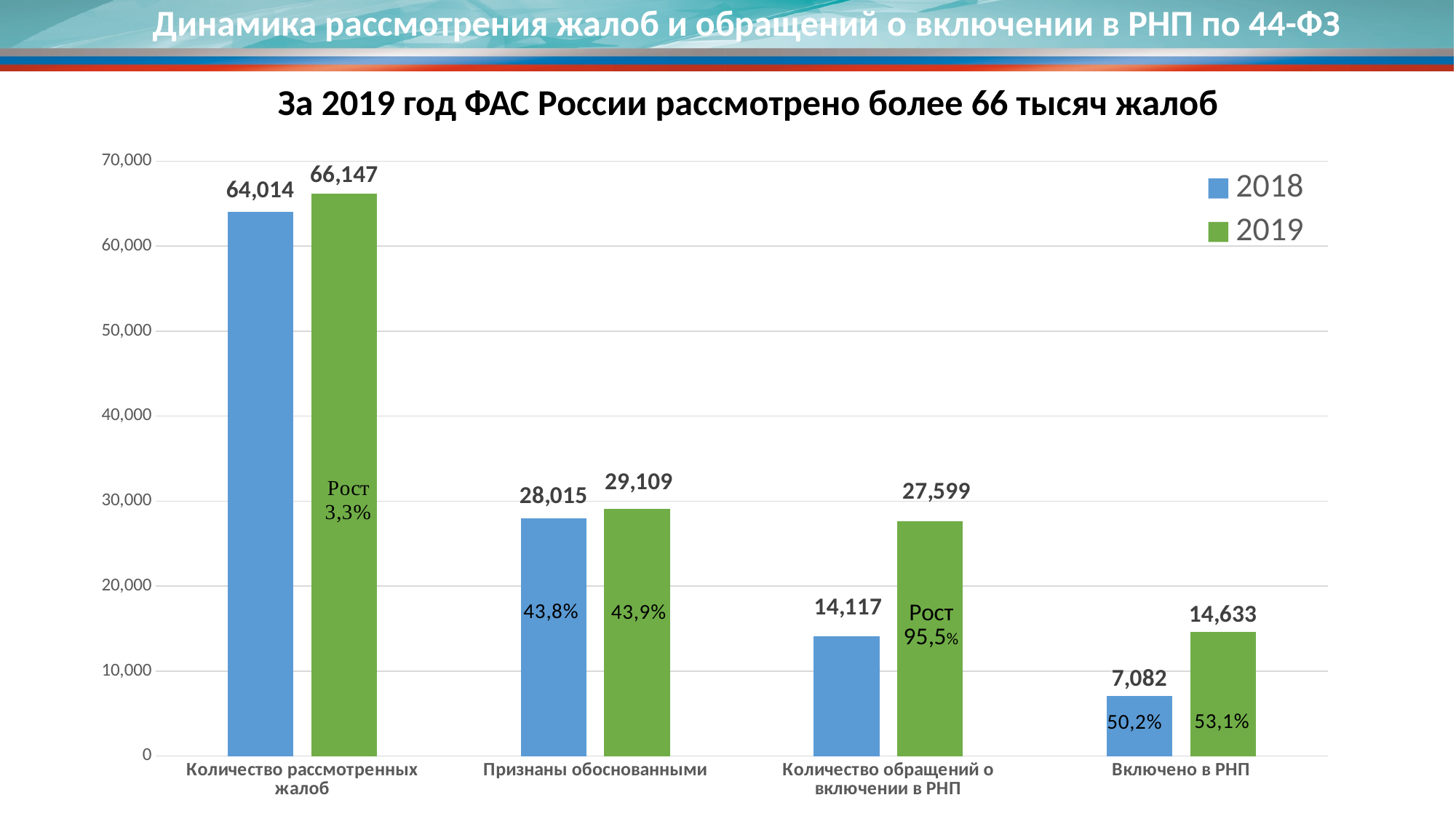
What is the 2019 value for "Количество рассмотренных жалоб"? 66,147 What is the difference between the 2019 and 2018 values for "Количество обращений о включении в РНП"? 13,482 Which category has the highest 2019 value? Количество рассмотренных жалоб What is the 2018 value for "Включено в РНП"? 7,082 Is the 2019 value for "Признаны обоснованными" greater or less than 30,000? less How many categories are shown on the x axis? 4 Which category has the lowest 2018 value? Включено в РНП What is the 2018 value for "Количество обращений о включении в РНП"? 14,117 What type of chart is shown on the slide? Bar chart How many series does the legend list? 2 What is the difference between the 2019 and 2018 values for "Включено в РНП"? 7,551 Which is larger: the 2018 value for "Признаны обоснованными" or the 2019 value for "Признаны обоснованными"? 2019 (29,109)